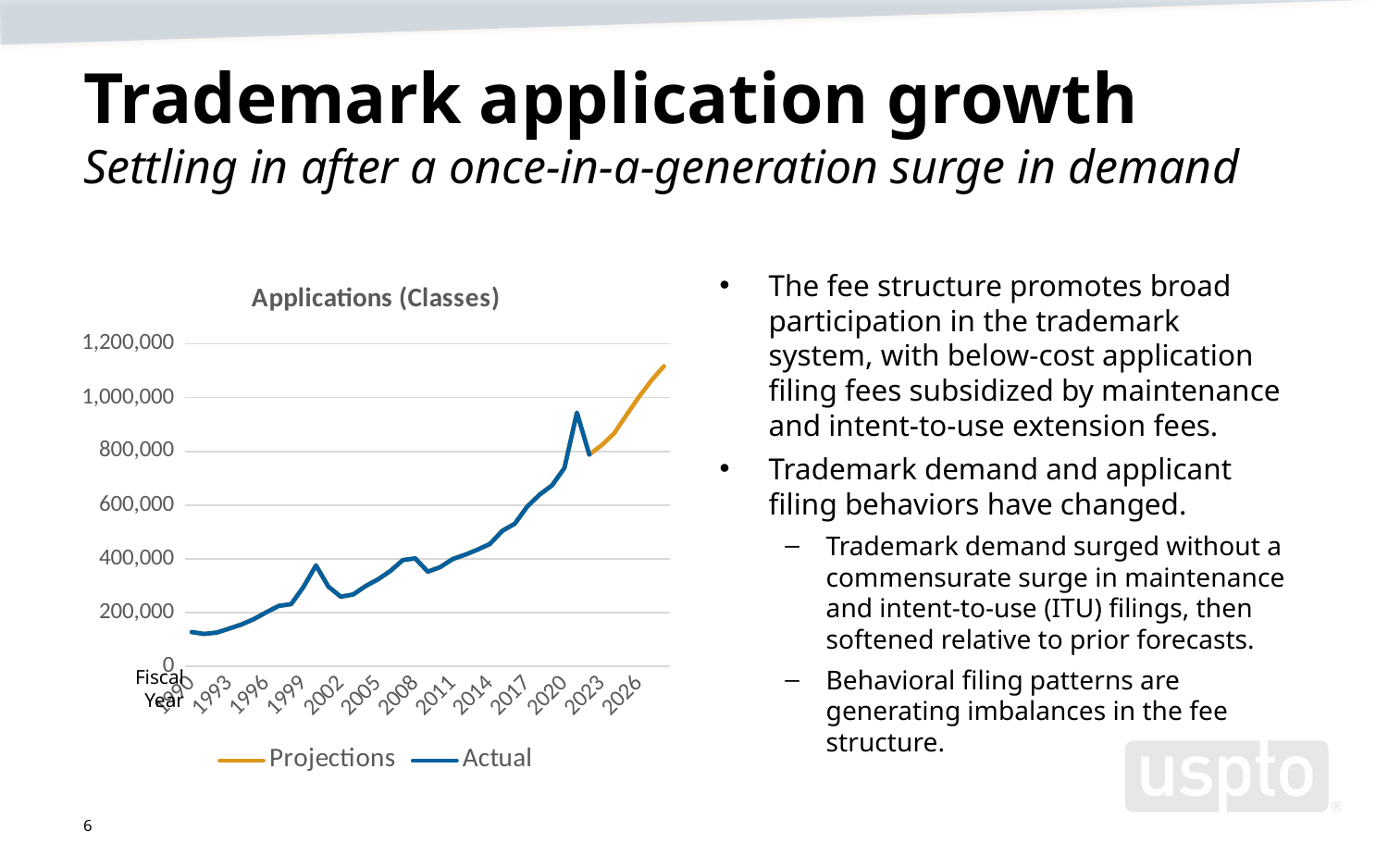
Is the Actual value for fiscal year 2017 greater or less than 400,000? greater Is the Actual value for fiscal year 1990 greater or less than 200,000? less Overall, do the values in the chart rise or fall from 1990 to 2026? rise Which series in the chart is drawn in orange? Projections What kind of chart is shown on the slide? Line chart How many series does the legend of the chart list? 2 Is the highest value reached by the Actual series greater or less than 800,000? greater What is the title of the chart? Applications (Classes) What is the first fiscal year labeled on the x axis of the chart? 1990